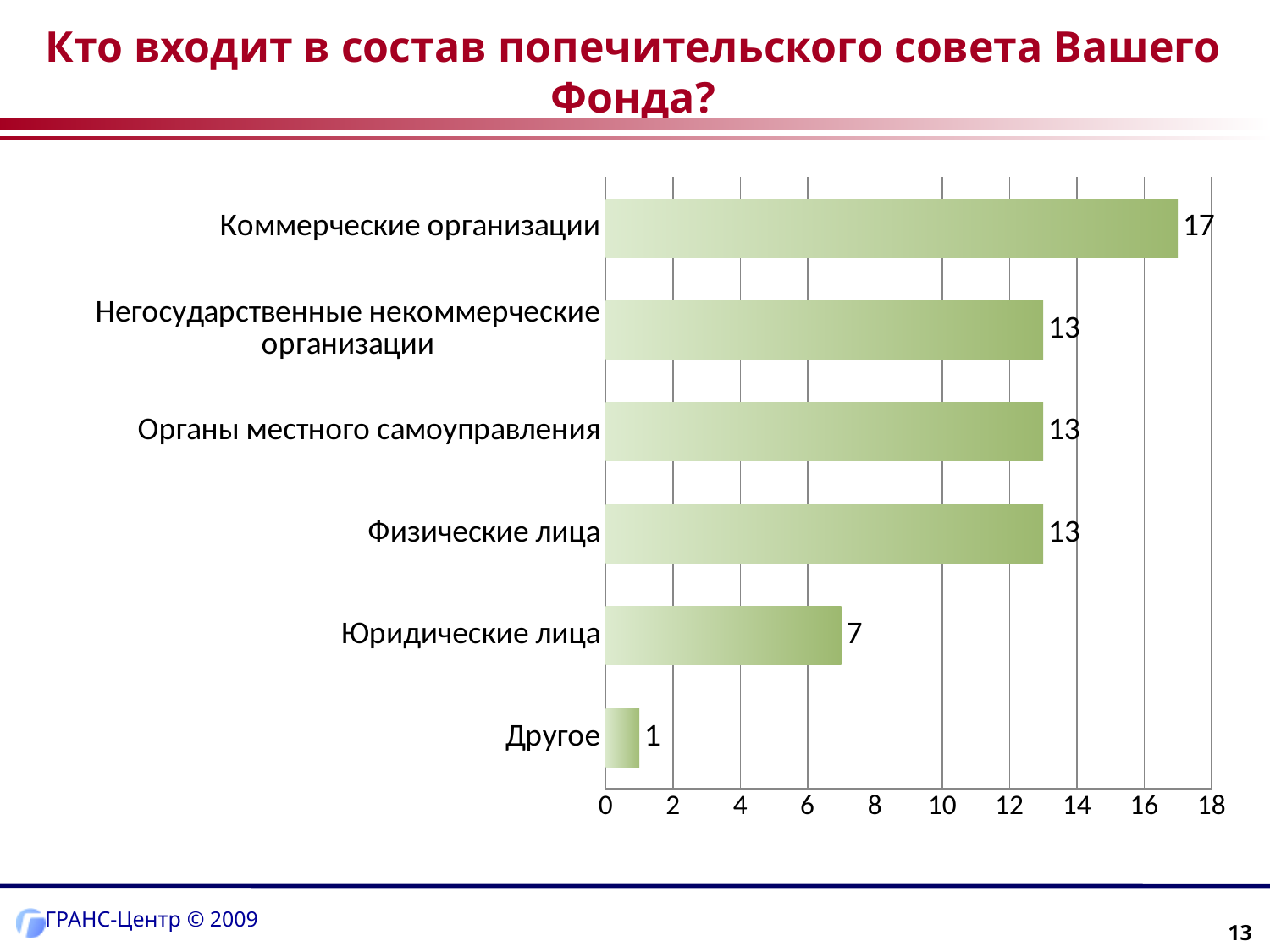
Which category has the lowest value? Другое Which category has the highest value? Коммерческие организации What kind of chart is shown on the slide? bar chart Which is larger, the value for Негосударственные некоммерческие организации or the value for Юридические лица? Негосударственные некоммерческие организации Is the value for Коммерческие организации greater or less than 16? greater What is the value for Другое? 1 What is the value for Физические лица? 13 How many categories are shown in the chart? 6 What is the value for Коммерческие организации? 17 What is the value for Юридические лица? 7 What is the difference between the values for Коммерческие организации and Юридические лица? 10 What is the difference between the values for Органы местного самоуправления and Другое? 12